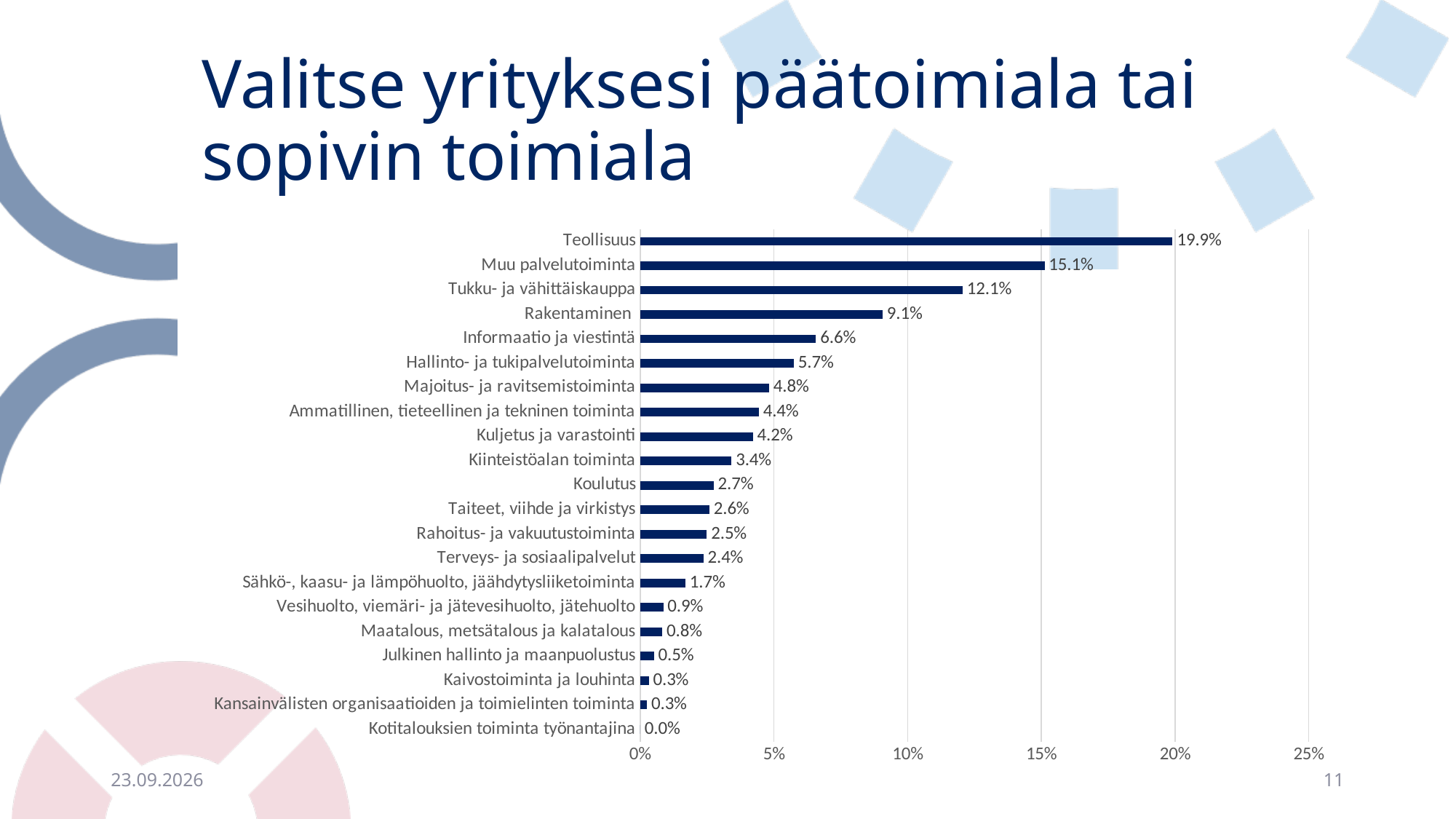
How many categories are shown in the chart? 21 Is the value for Tukku- ja vähittäiskauppa greater or less than 10%? greater What is the title of the slide? Valitse yrityksesi päätoimiala tai sopivin toimiala Which is larger, the value for Informaatio ja viestintä or the value for Hallinto- ja tukipalvelutoiminta? Informaatio ja viestintä What is the value for Rakentaminen? 9.1% What is the value for Teollisuus? 19.9% Which category has the lowest value? Kotitalouksien toiminta työnantajina What is the difference between the values for Teollisuus and Muu palvelutoiminta? 4.8% What is the value for Kotitalouksien toiminta työnantajina? 0.0% Which category has the highest value? Teollisuus What kind of chart is shown on the slide? bar chart What is the value for Koulutus? 2.7%